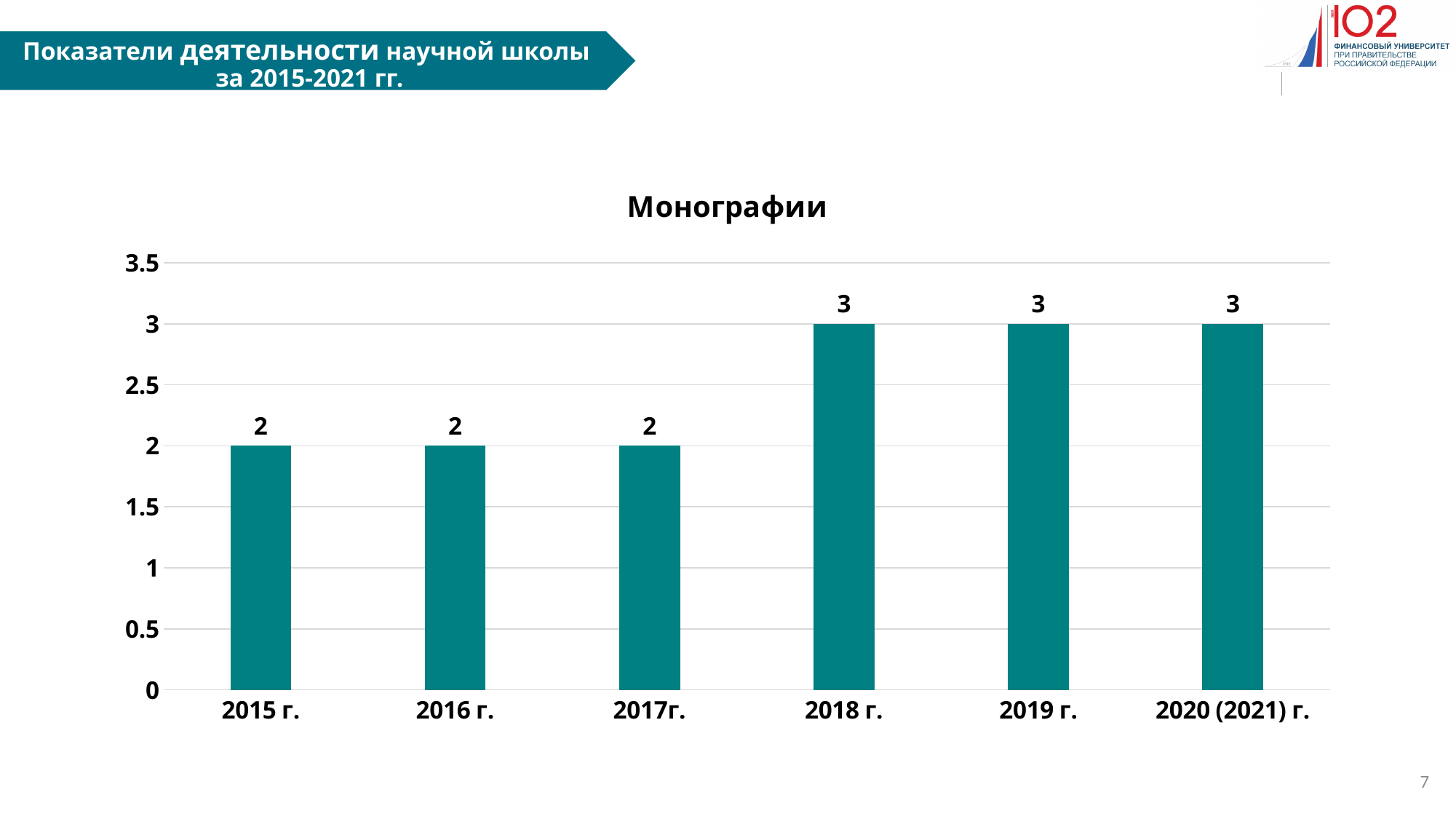
What is the value for 2017г. in the Монографии chart? 2 What kind of chart is shown on the slide? bar chart Is the value for 2019 г. greater or less than 2.5? greater Is the value for 2016 г. greater or less than 2.5? less What is the value for 2020 (2021) г. in the Монографии chart? 3 Which is larger, the value for 2016 г. or the value for 2019 г.? 2019 г. How many categories are shown on the x axis of the chart? 6 What is the title of the chart? Монографии What is the value for 2018 г. in the Монографии chart? 3 Do the values rise or fall from 2017г. to 2018 г.? rise What is the difference between the values for 2018 г. and 2017г.? 1 What is the value for 2015 г. in the Монографии chart? 2